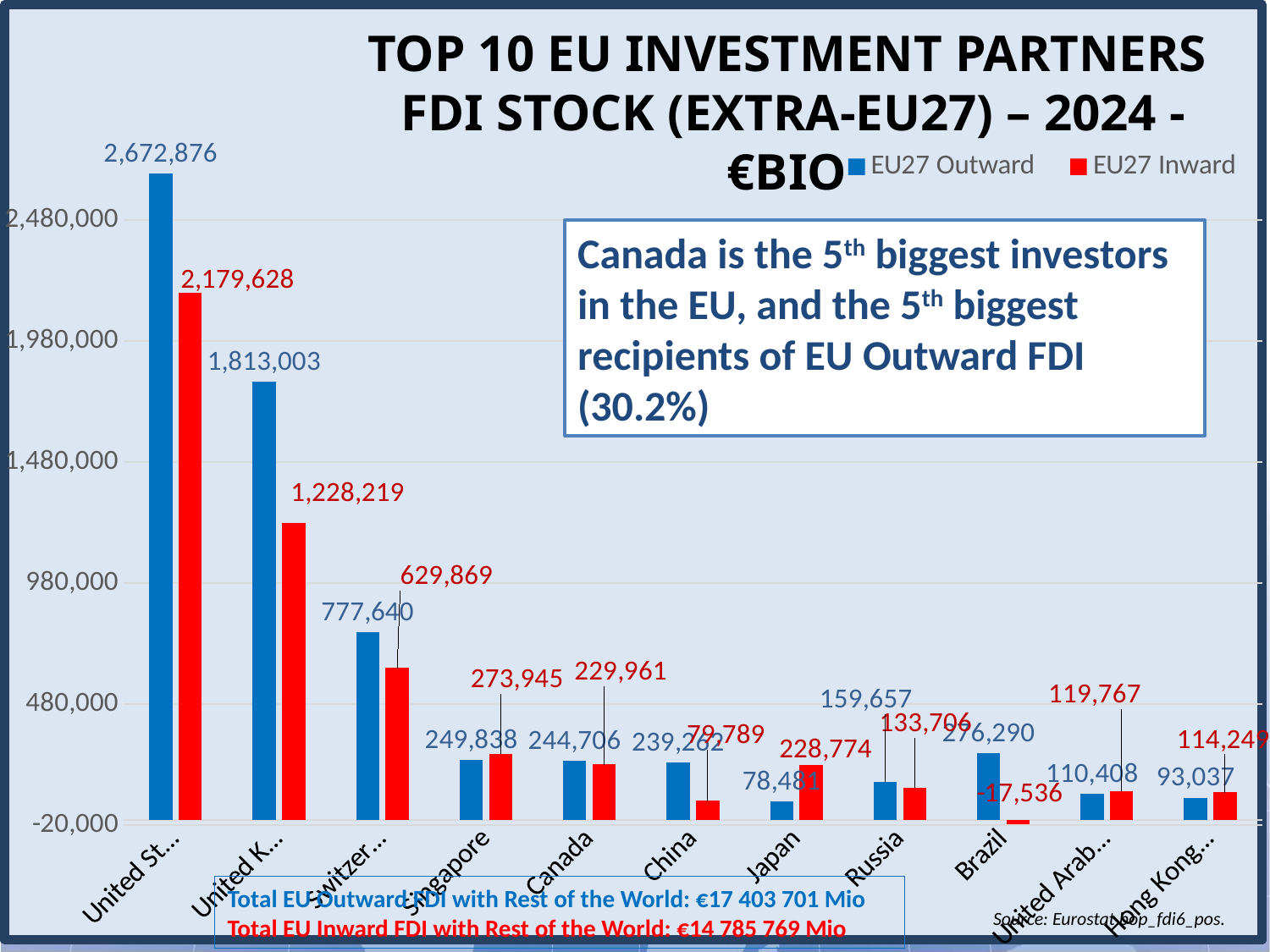
What is the EU27 Inward FDI stock value for the United Kingdom? 1,228,219 For Japan, which is larger: EU27 Outward or EU27 Inward? EU27 Inward What colour represents EU27 Inward in the legend? Red What is the EU27 Outward FDI stock value for the United States? 2,672,876 How many partner categories are plotted on the x axis? 11 What is the difference between the EU27 Outward and EU27 Inward values for the United States? 493,248 What kind of chart is shown on the slide? Bar chart Which partner has the highest EU27 Outward FDI stock? United States How many series does the legend list? 2 What is the EU27 Outward value shown for Canada? 244,706 What is the EU27 Inward value shown for Switzerland? 629,869 Which partner has the lowest EU27 Inward FDI stock? Brazil